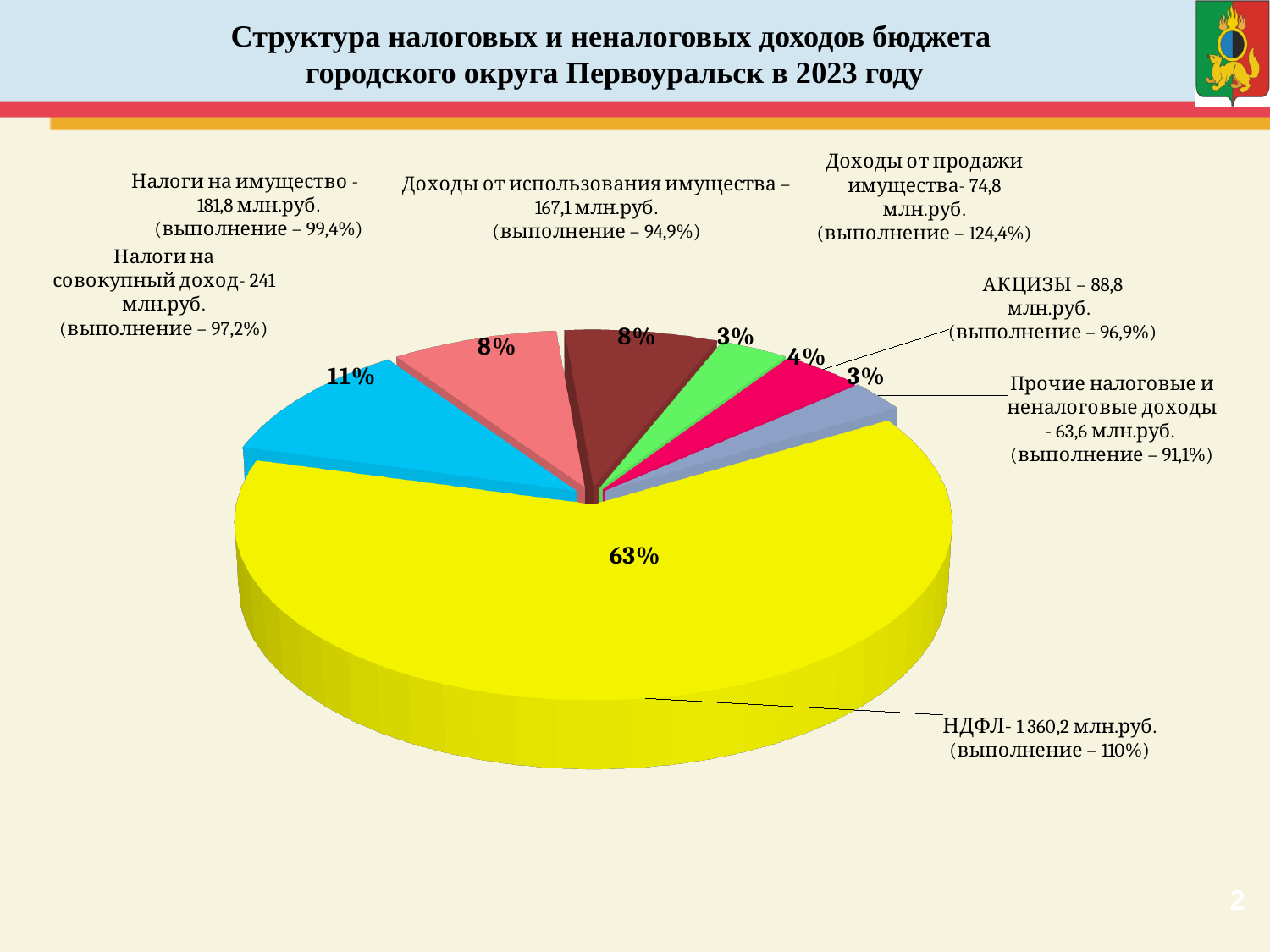
What kind of chart is shown on the slide? pie chart What is the amount shown for Налоги на совокупный доход? 241 млн.руб. What share of the pie do Прочие налоговые и неналоговые доходы account for? 3% Which category has the smallest amount in млн.руб.? Прочие налоговые и неналоговые доходы What is the amount shown for НДФЛ? 1 360,2 млн.руб. How many slices does the pie chart have? 7 What share of the pie does НДФЛ account for? 63% What execution percentage (выполнение) is shown for Доходы от продажи имущества? 124,4% What is the difference in млн.руб. between НДФЛ and Налоги на совокупный доход? 1 119,2 млн.руб. What share of the pie do АКЦИЗЫ account for? 4% Which is larger in млн.руб.: Налоги на имущество or Доходы от использования имущества? Налоги на имущество Which category has the largest share of the pie? НДФЛ